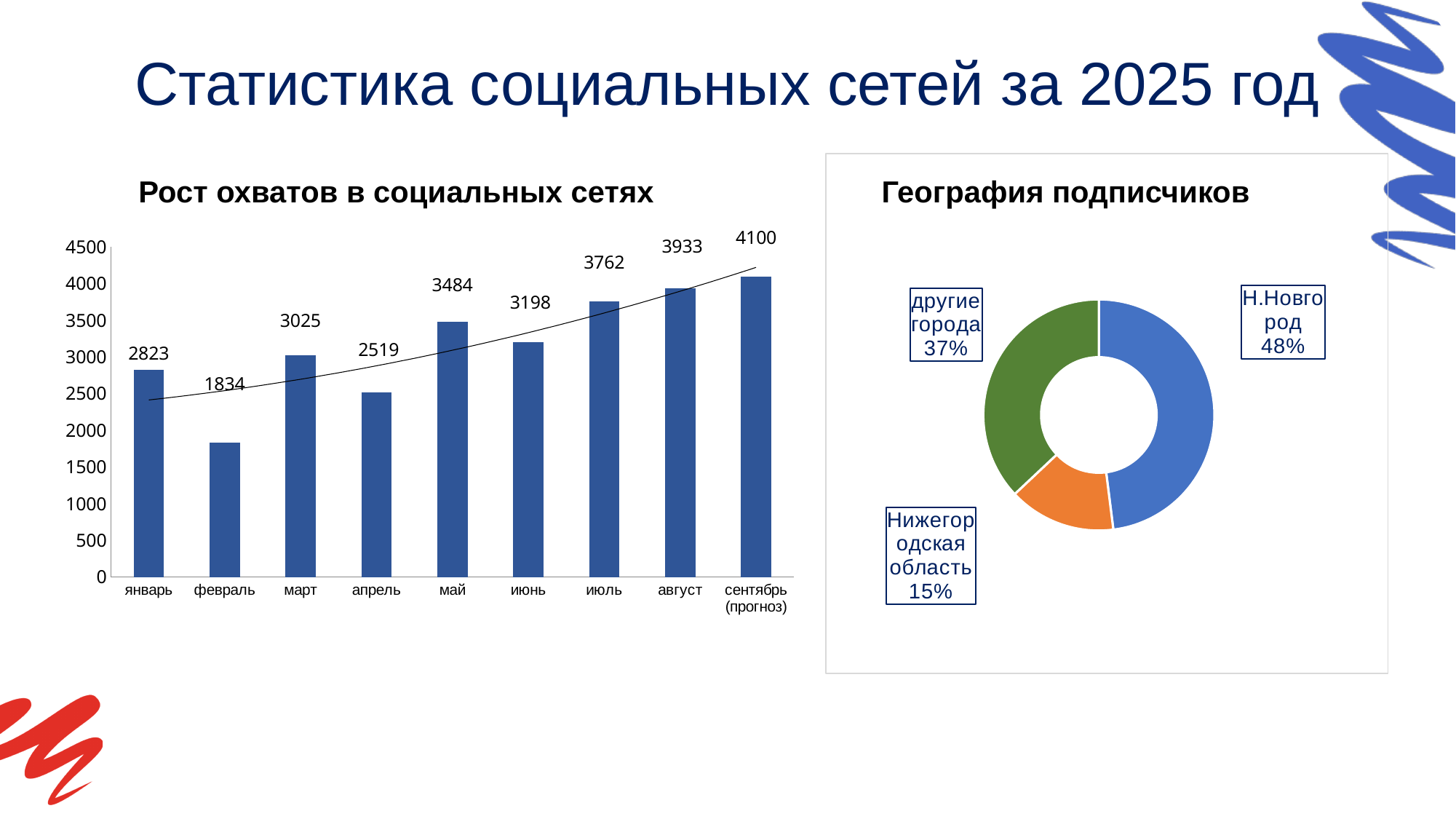
In the chart 'Рост охватов в социальных сетях', which month has the lowest value? февраль In the chart 'Рост охватов в социальных сетях', what is the difference between the values for август and июль? 171 In the chart 'География подписчиков', how many segments are there? 3 In the chart 'Рост охватов в социальных сетях', which is larger, the value for март or the value for июнь? июнь What kind of chart is 'Рост охватов в социальных сетях'? bar chart In the chart 'География подписчиков', what share of subscribers is from Н.Новгород? 48% In the chart 'География подписчиков', which segment is the smallest? Нижегородская область In the chart 'Рост охватов в социальных сетях', which month has the highest value? сентябрь (прогноз) In the chart 'Рост охватов в социальных сетях', how many months are shown on the x axis? 9 In the chart 'Рост охватов в социальных сетях', do the values generally rise or fall from апрель to сентябрь (прогноз)? rise In the chart 'Рост охватов в социальных сетях', what is the value for сентябрь (прогноз)? 4100 In the chart 'Рост охватов в социальных сетях', what is the value for май? 3484